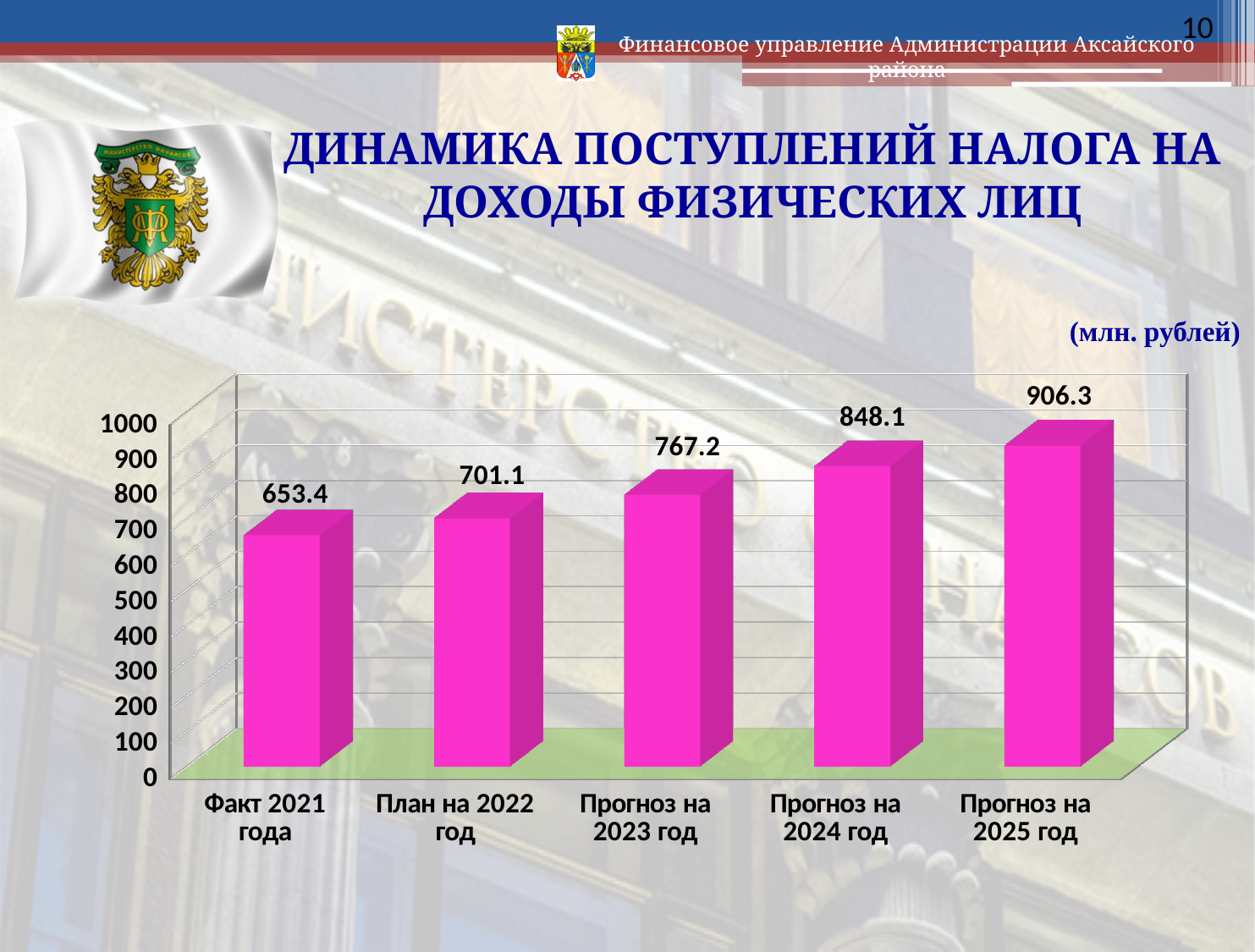
What is the value for Прогноз на 2024 год? 848.1 Do the values rise or fall from Факт 2021 года to Прогноз на 2025 год? rise What is the difference between the values for Прогноз на 2025 год and Факт 2021 года? 252.9 Which category has the highest value? Прогноз на 2025 год What is the difference between the values for Прогноз на 2023 год and План на 2022 год? 66.1 What is the value for Факт 2021 года? 653.4 Is the value for Прогноз на 2025 год greater or less than 900? greater What kind of chart is shown on the slide? bar chart What is the value for План на 2022 год? 701.1 How many categories are shown on the x axis? 5 Which is larger, the value for Прогноз на 2024 год or the value for Прогноз на 2023 год? Прогноз на 2024 год Which category has the lowest value? Факт 2021 года